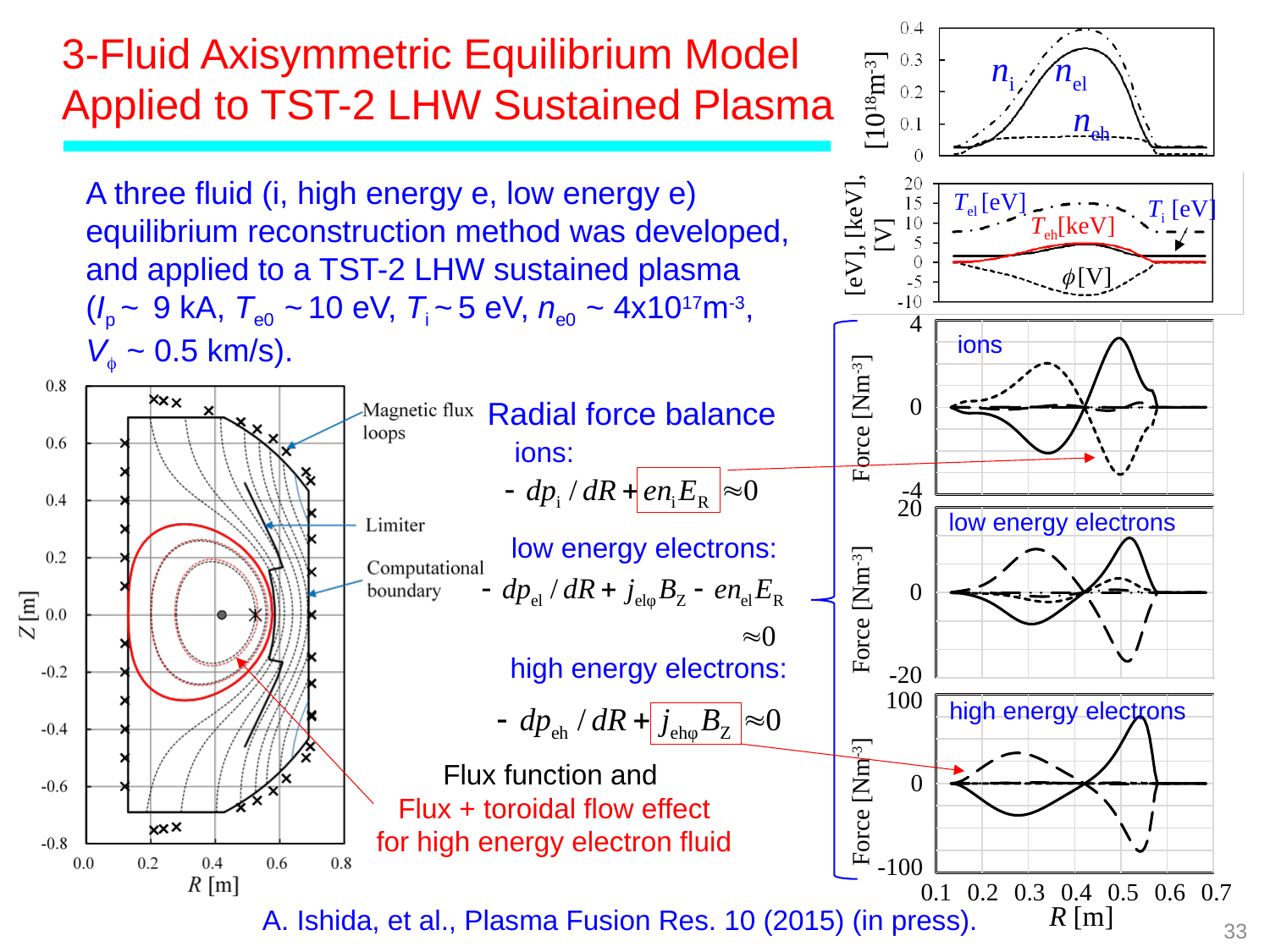
What is the x-axis label shared by the force balance charts on the right? R [m] What kind of chart is the density profile chart at the top right of the slide? line chart In the 'ions' force chart, is the peak of the solid curve near R = 0.5 m greater or less than 0? greater In the temperature and potential chart (second from top on the right), is the minimum value of the phi [V] curve greater or less than -5? less How many force balance charts are stacked on the right side of the slide? 3 In the density profile chart at the top right, is the peak value of n_eh greater or less than 0.1? less In the density profile chart at the top right, which curve reaches a higher peak, n_i or n_eh? n_i What is the y-axis label of the three force balance charts on the right? Force [Nm^-3] How many curves are plotted in the temperature and potential chart (second from top on the right)? 4 How many curves are plotted in the density profile chart at the top right (n_i, n_el, n_eh)? 3 In the temperature and potential chart (second from top on the right), which curve reaches a higher peak, T_el [eV] or T_i [eV]? T_el [eV]